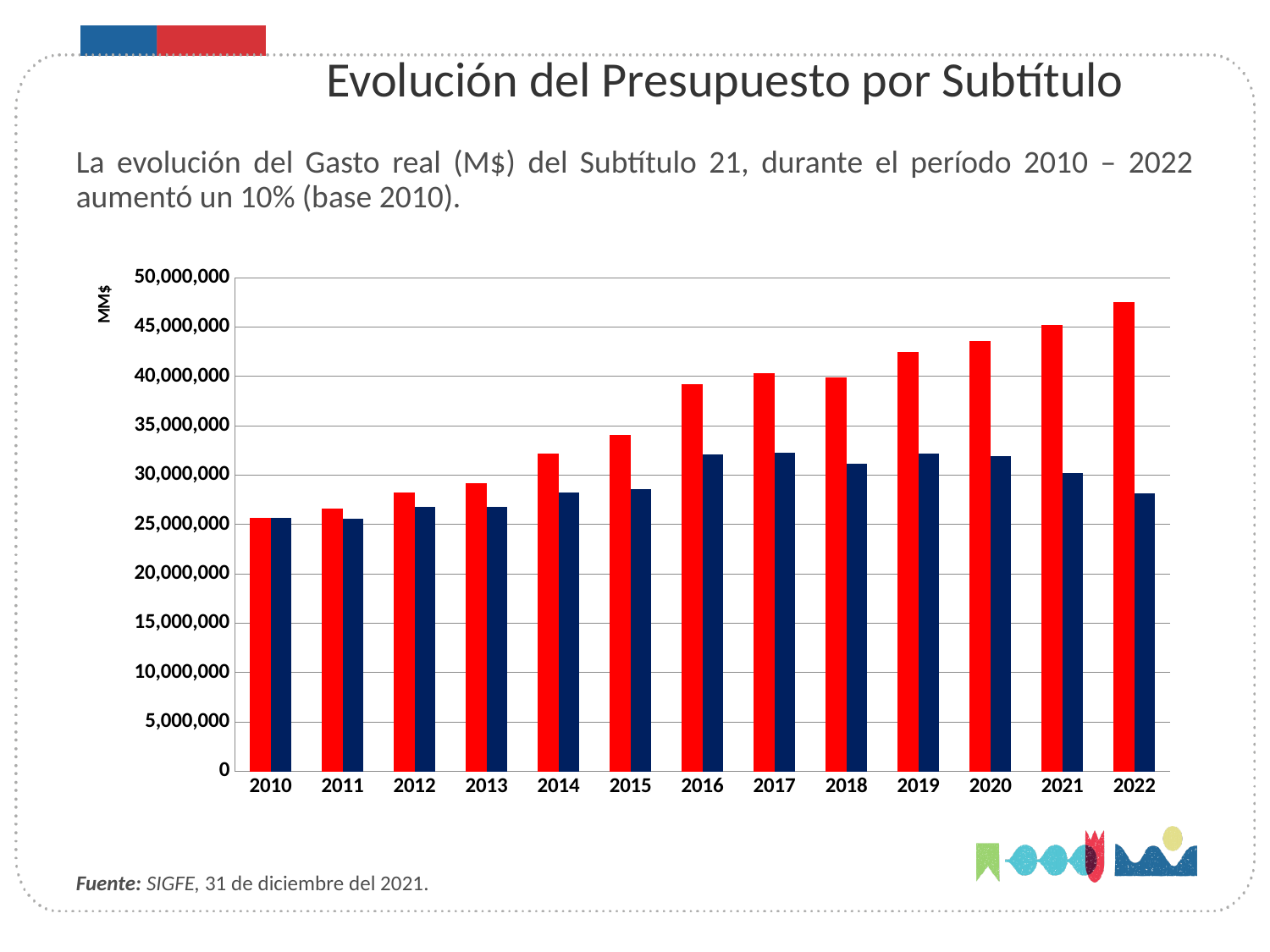
Is the value of the red bar for 2015 greater or less than 35,000,000? less Is the value of the dark blue bar for 2016 greater or less than 30,000,000? greater For 2022, which bar is larger, the red bar or the dark blue bar? the red bar In which year is the red bar the tallest? 2022 Which is larger, the dark blue bar for 2017 or the dark blue bar for 2022? the dark blue bar for 2017 How many years are shown on the x axis of the chart? 13 In which year is the red bar the shortest? 2010 Is the value of the red bar for 2019 greater or less than 40,000,000? greater What kind of chart is shown on the slide? bar chart Do the red bars generally rise or fall from 2010 to 2022? rise